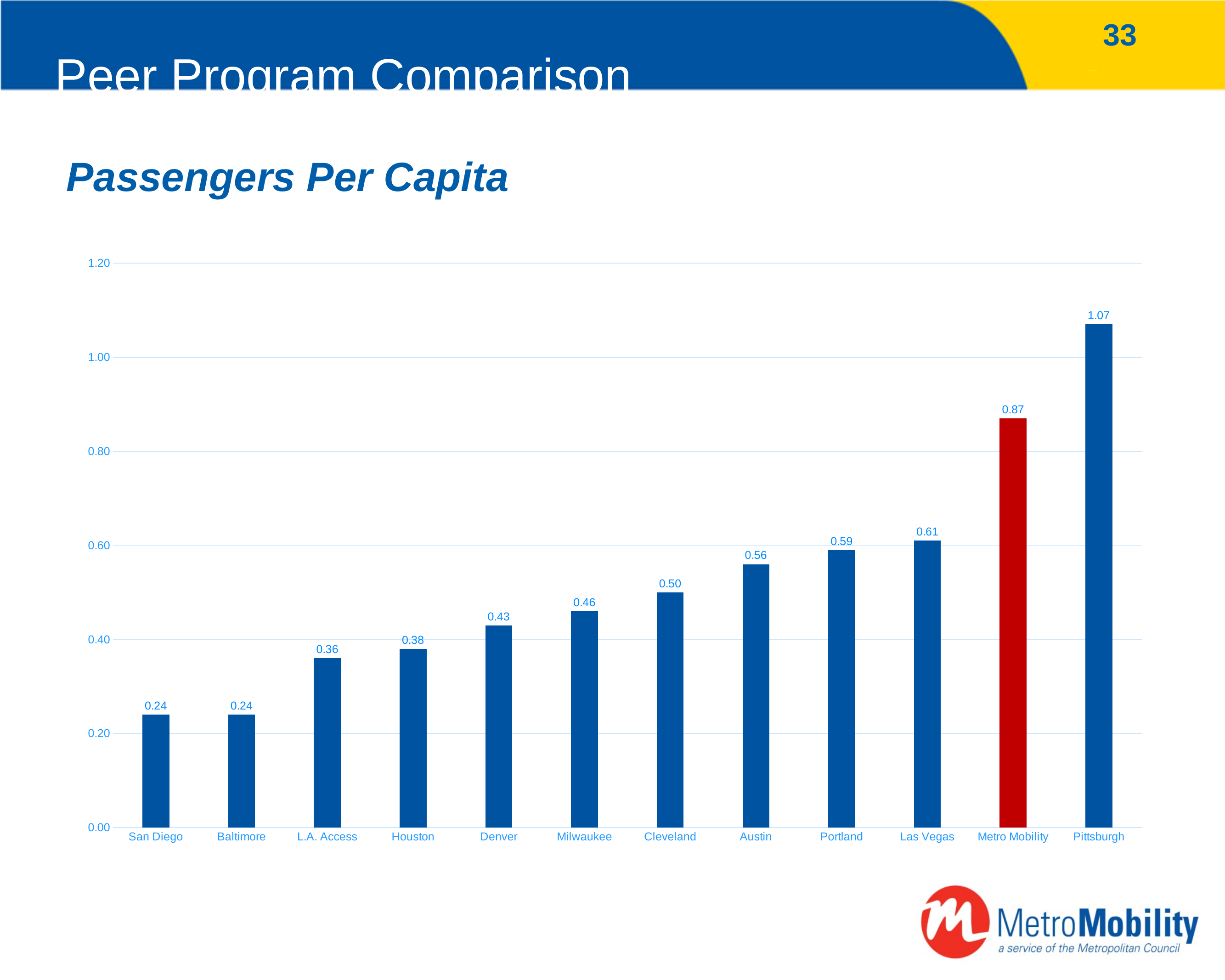
What is the passengers per capita value for Metro Mobility? 0.87 What is the passengers per capita value for Las Vegas? 0.61 Which bar is coloured red rather than blue? Metro Mobility Which program has the highest passengers per capita? Pittsburgh What is the difference in passengers per capita between Cleveland and Houston? 0.12 Is the value for Portland greater or less than 0.60? less Do the values generally rise or fall from left to right across the chart? rise What is the passengers per capita value for Denver? 0.43 What kind of chart is shown on the slide? bar chart How many programs are shown on the chart? 12 Which has a higher passengers per capita value, Austin or Milwaukee? Austin What is the difference in passengers per capita between Pittsburgh and Metro Mobility? 0.20